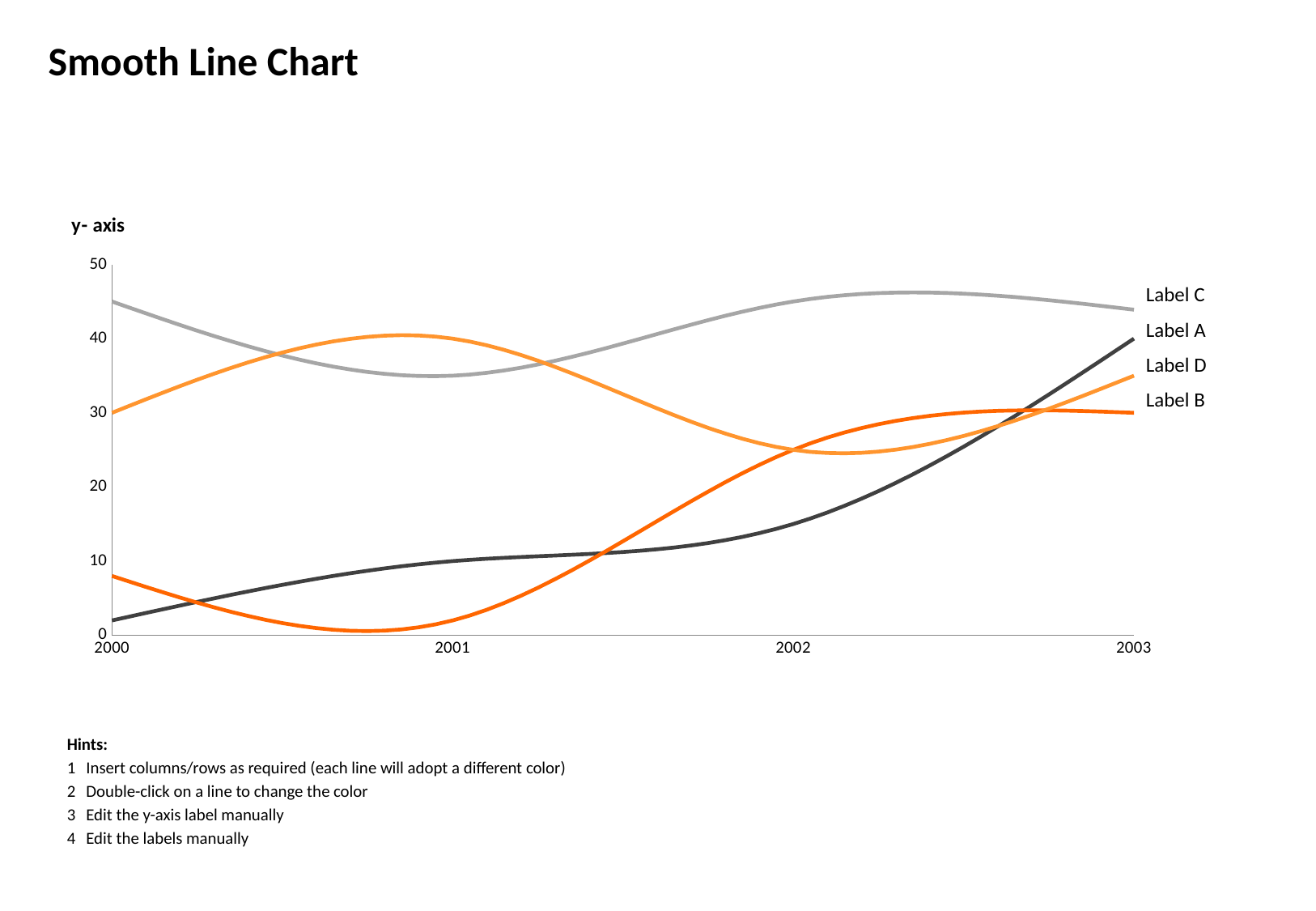
How many series (labelled lines) does the chart show? 4 How many years are marked on the x axis of the chart? 4 Which series has the lowest value at 2000? Label A Is the value for Label A at 2002 greater or less than 20? less What kind of chart is shown on the slide? line chart Does the line for Label A rise or fall from 2000 to 2003? rises What is the title of the chart on the slide? Smooth Line Chart Which series has the highest value at 2000? Label C At 2001, which series has the larger value, Label D or Label C? Label D Is the value for Label C at 2002 greater or less than 40? greater Which series has the highest value at 2003? Label C Is the value for Label B at 2001 greater or less than 10? less